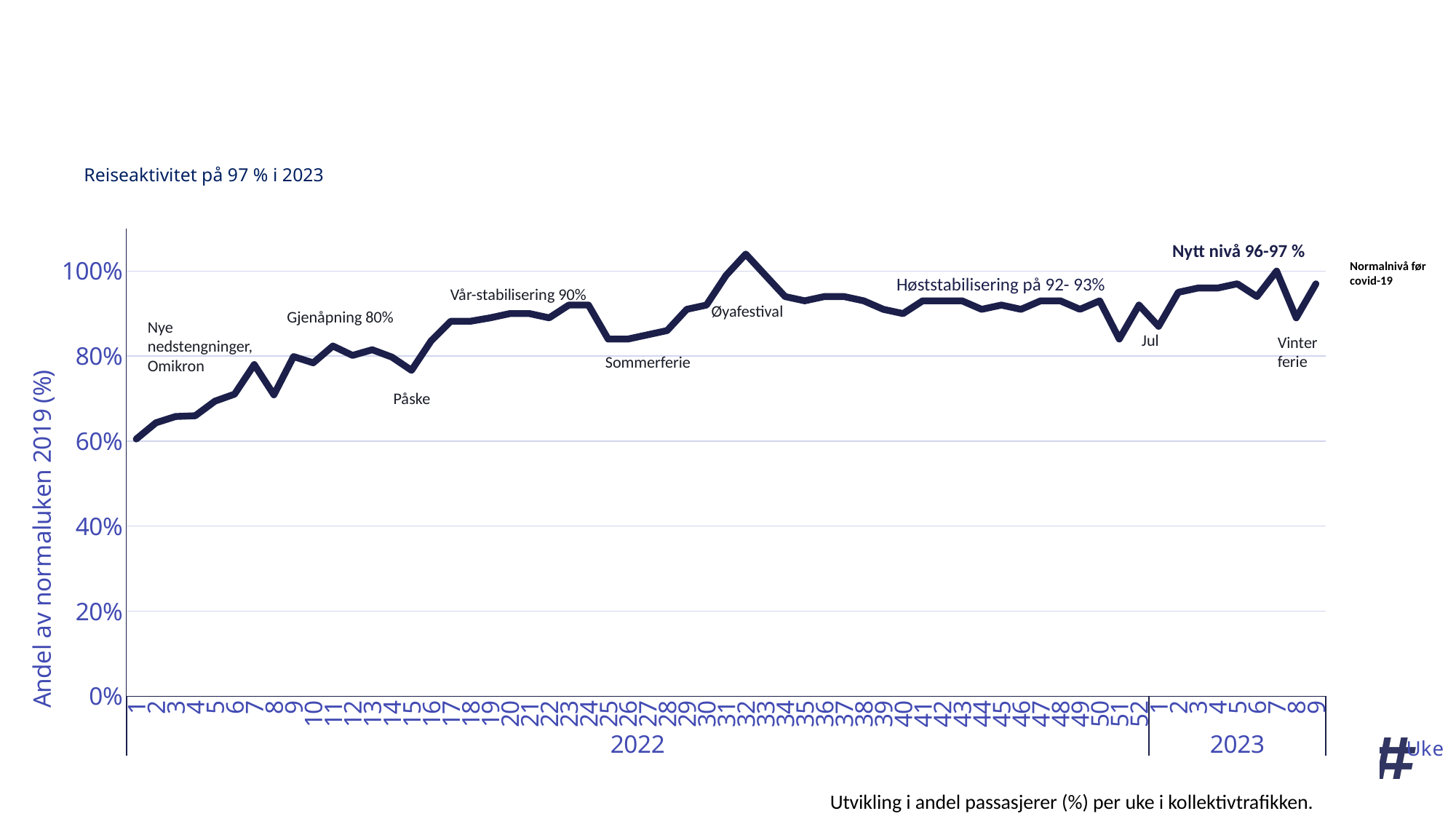
Do the values rise or fall from week 1 to week 7 of 2022? rise Is the value for week 32 of 2022 greater or less than 100%? greater Which is larger, the value for week 32 of 2022 or week 33 of 2022? week 32 of 2022 Is the value for week 9 of 2023 greater or less than 80%? greater What kind of chart is shown on the slide? line chart Which is larger, the value for week 7 of 2022 or week 8 of 2022? week 7 of 2022 What is the label of the vertical axis? Andel av normaluken 2019 (%) How many weeks of 2023 are shown on the x axis? 9 Which week has the lowest value on the chart? week 1 of 2022 What is the title of the chart? Reiseaktivitet på 97 % i 2023 Which week has the highest value on the chart? week 32 of 2022 Is the value for week 1 of 2022 greater or less than 80%? less